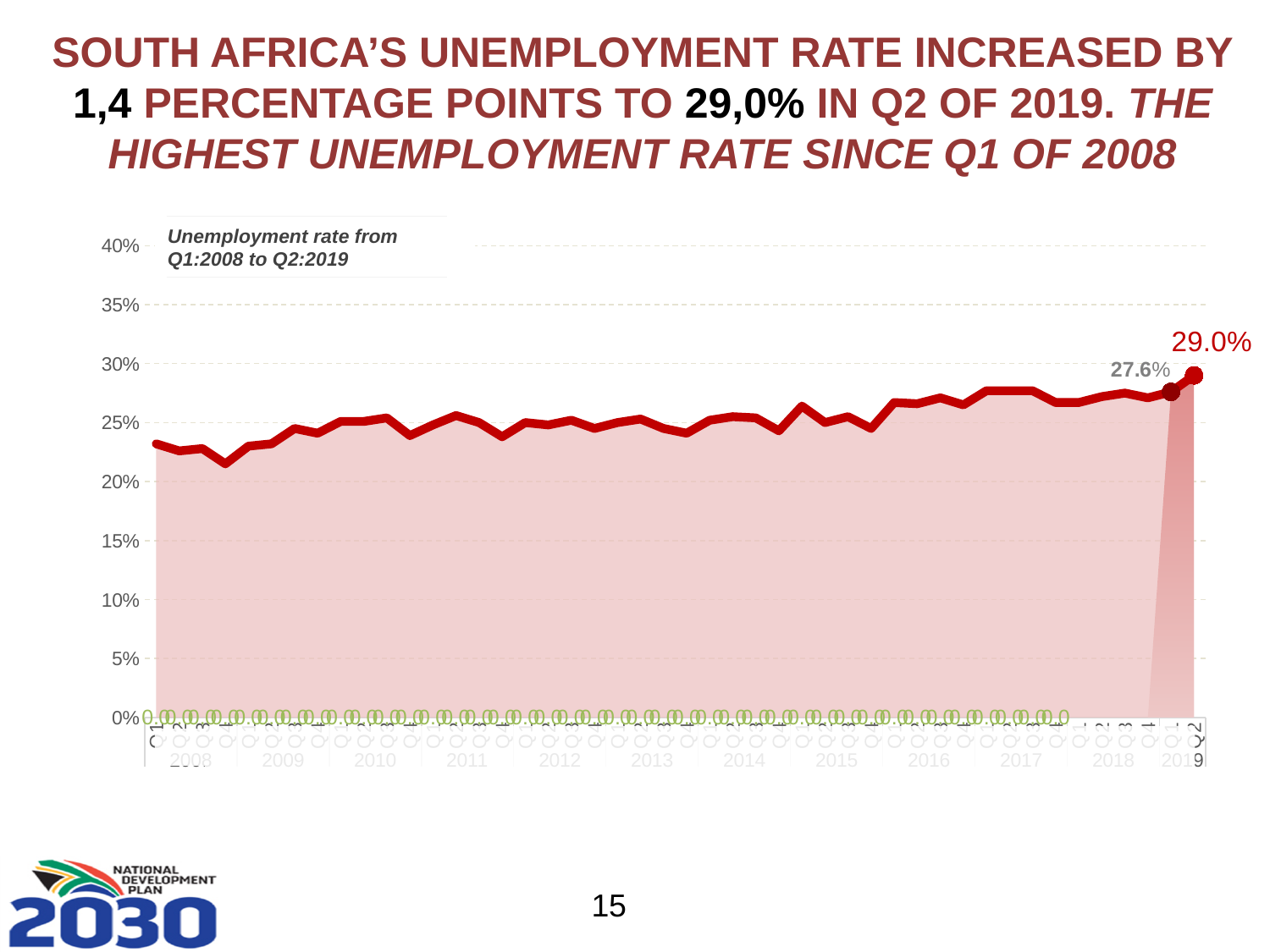
In which year does the lowest point of the unemployment rate line occur? 2008 Which quarter has the highest unemployment rate on the chart? Q2 2019 What is the unemployment rate shown for Q1 of 2019? 27.6% Is the unemployment rate at the start of the series in Q1 2008 greater or less than 25%? less How many years are labelled along the x axis of the chart? 12 Which is higher, the unemployment rate in Q1 2019 or in Q2 2019? Q2 2019 Overall, does the unemployment rate rise or fall from 2008 to 2019? rise What is the title of the chart? Unemployment rate from Q1:2008 to Q2:2019 What is the unemployment rate shown for Q2 of 2019? 29.0% Is the unemployment rate for Q2 2019 greater or less than 30%? less What kind of chart is used to show the unemployment rate? area chart (a line with the area beneath it shaded) By how many percentage points did the unemployment rate change between Q1 2019 (27.6%) and Q2 2019 (29.0%)? 1.4 percentage points